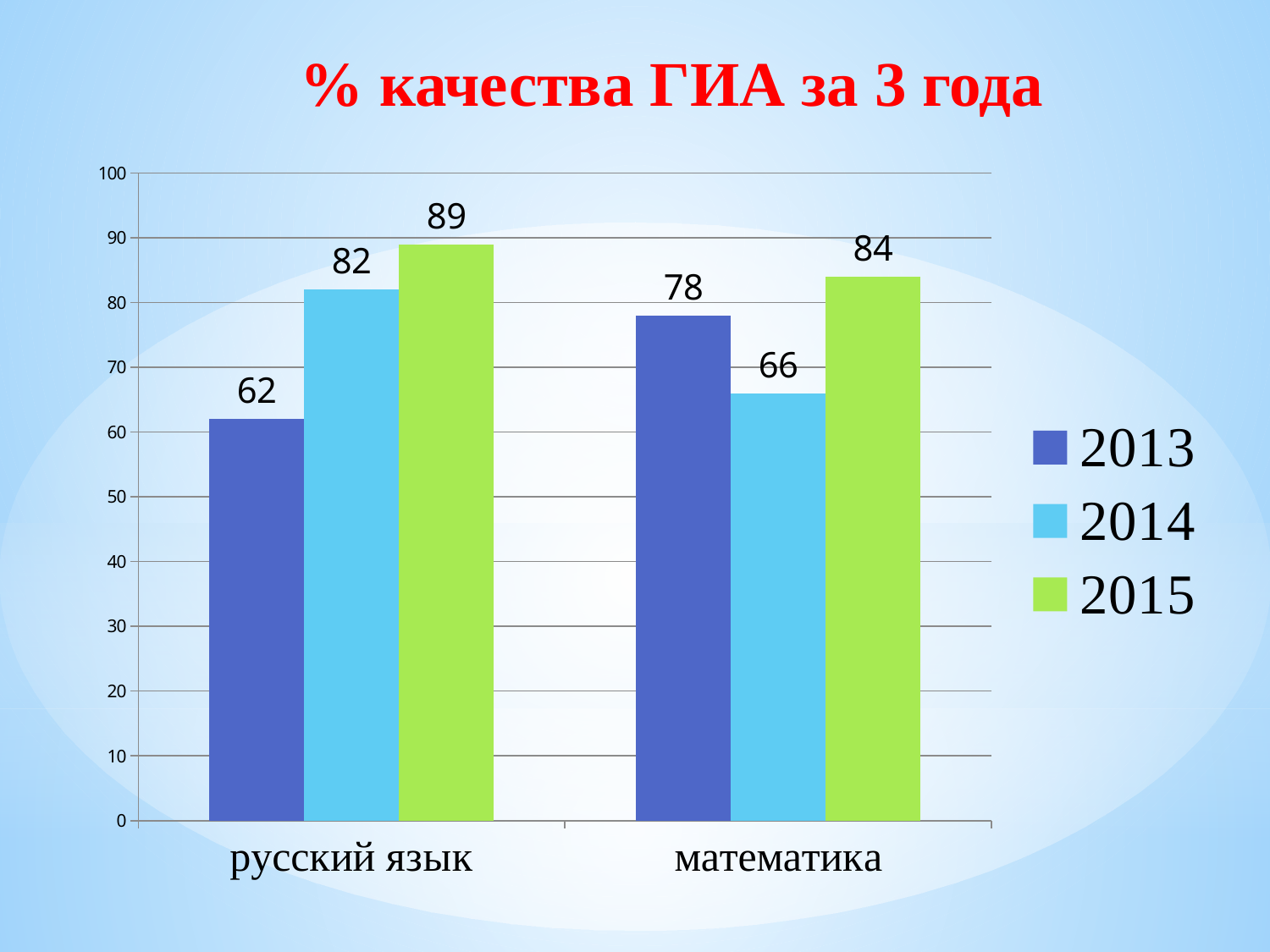
Which year has the lowest value for русский язык? 2013 What is the value for русский язык in 2015? 89 What kind of chart is shown on the slide? bar chart How many categories are shown on the x axis? 2 How many series does the legend list? 3 What is the value for математика in 2013? 78 Which is larger: the 2014 value for русский язык or the 2014 value for математика? русский язык What is the difference between the 2015 and 2013 values for русский язык? 27 What is the title of the chart? % качества ГИА за 3 года What is the value for математика in 2014? 66 Which year has the highest value for математика? 2015 What is the value for русский язык in 2013? 62